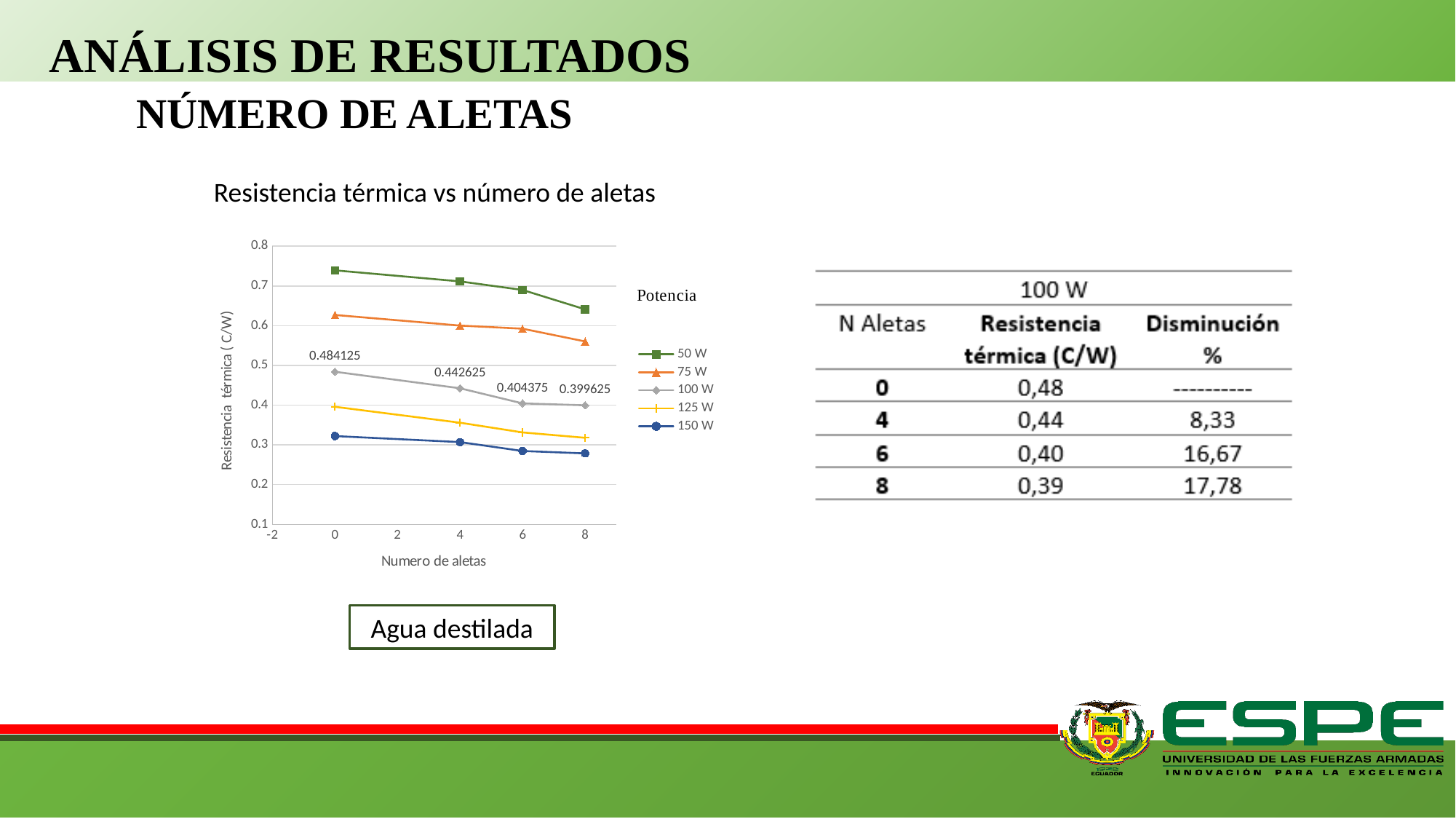
What is the thermal resistance for the 100 W series at 0 fins (aletas)? 0.484125 What is the thermal resistance for the 100 W series at 4 fins? 0.442625 Which series has the lowest thermal resistance across all numbers of fins? 150 W Does the thermal resistance rise or fall as the number of fins increases? fall Is the value for the 150 W series at 8 fins greater or less than 0.3? less Which series has the highest thermal resistance across all numbers of fins? 50 W What is the title of the chart? Resistencia térmica vs número de aletas How many series does the chart legend list? 5 What kind of chart is shown on the slide? line chart What is the difference between the 100 W values at 0 fins and 8 fins? 0.0845 What is the thermal resistance for the 100 W series at 8 fins? 0.399625 Is the value for the 50 W series at 0 fins greater or less than 0.7? greater